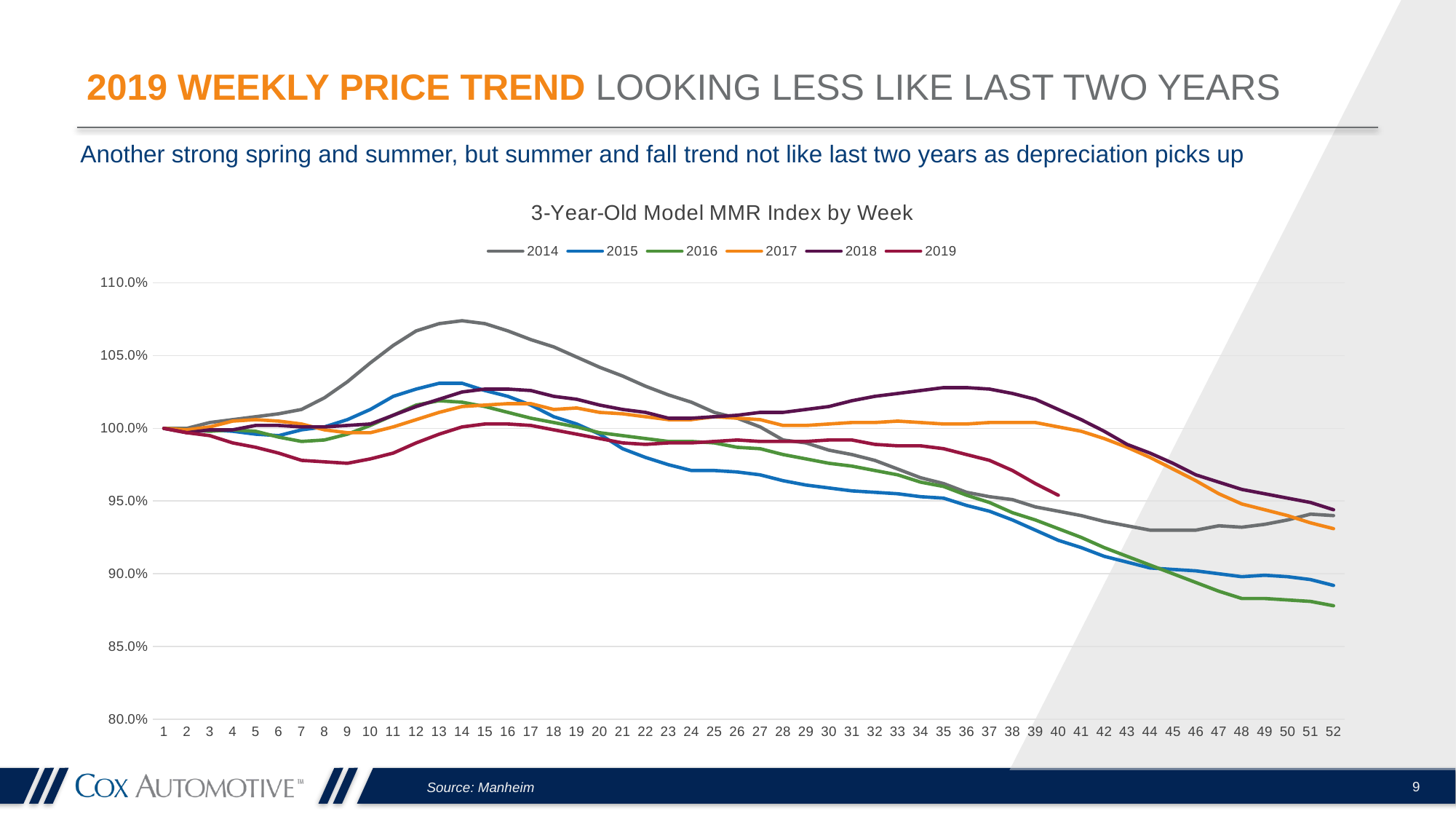
At week 52, which is higher: the 2018 line or the 2015 line? 2018 How many weeks are shown along the x axis? 52 Is the value for 2014 at week 14 greater or less than 105.0%? greater Which year's line reaches the highest value on the chart? 2014 Is the value for 2016 at week 52 greater or less than 90.0%? less Does the 2015 line rise or fall from week 14 to week 52? fall Which year's line is lowest at week 52? 2016 At which week does the 2019 line end? 40 How many series does the legend list? 6 What kind of chart is shown on the slide? line chart Is the value for 2018 at week 36 greater or less than 100.0%? greater What is the title of the chart? 3-Year-Old Model MMR Index by Week